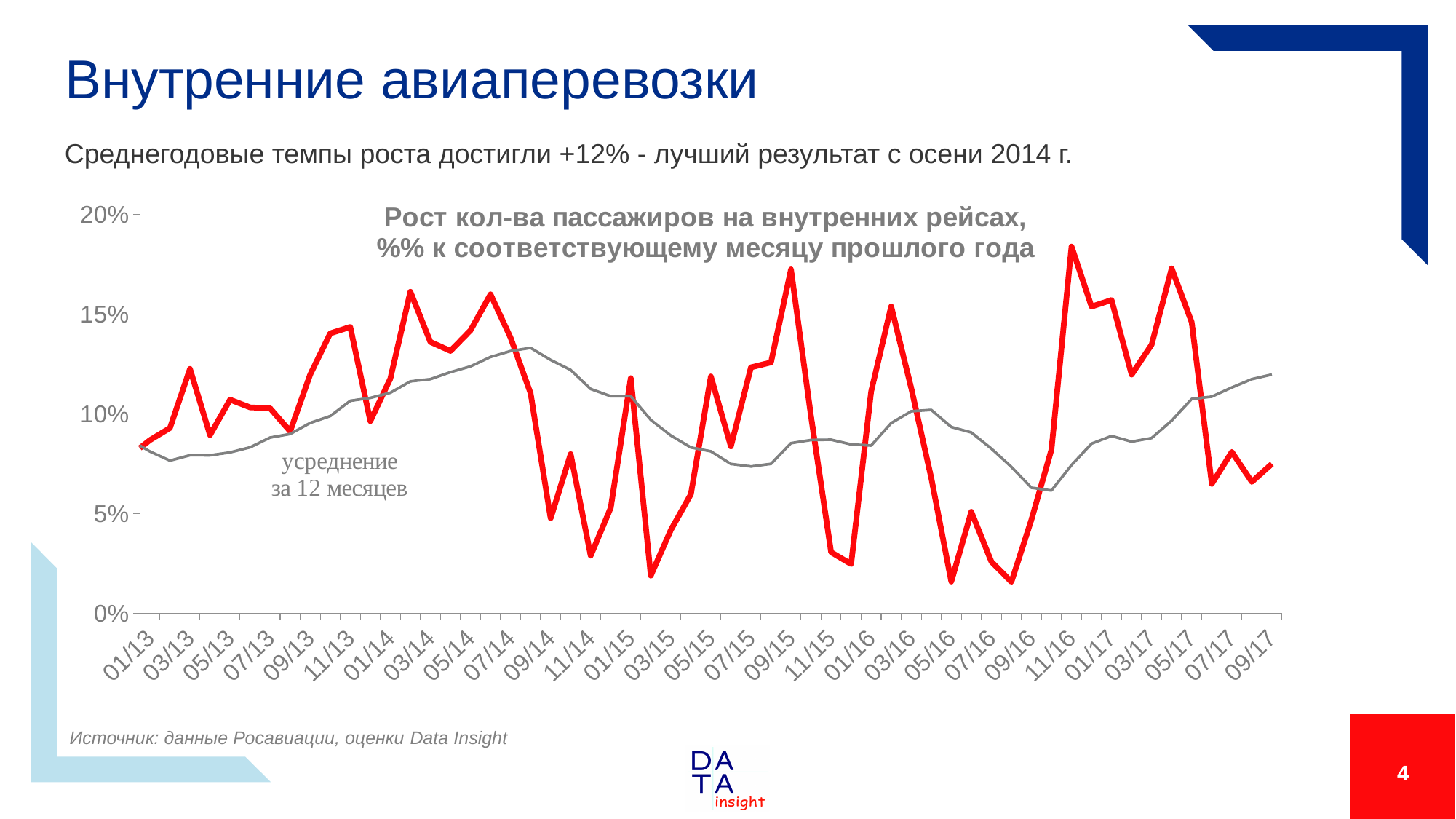
Is the value of the grey 12-month average line at 07/14 greater or less than 10%? greater Is the value of the red line at 11/16 greater or less than 15%? greater Is the value of the red line at 09/15 greater or less than 15%? greater What is the title of the chart? Рост кол-ва пассажиров на внутренних рейсах, %% к соответствующему месяцу прошлого года Which is larger: the red line's value at 11/16 or at 03/15? 11/16 What colour is the line labelled "усреднение за 12 месяцев"? grey At which month does the red line reach its highest peak? 11/16 Does the grey 12-month average line rise or fall between 09/16 and 09/17? rise What kind of chart is shown on the slide? line chart